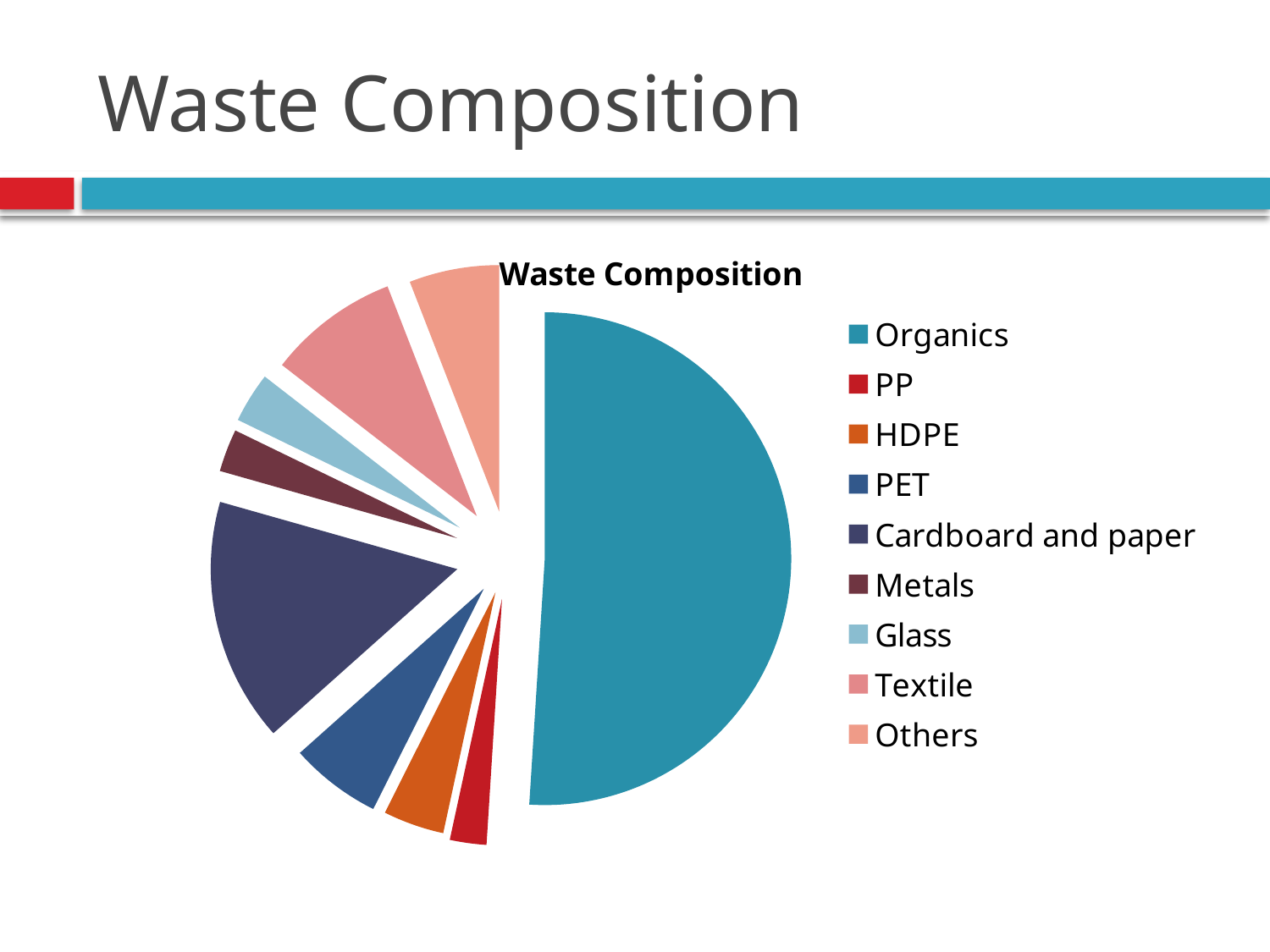
What is the title of the chart? Waste Composition How many categories does the pie chart show? 9 Which category is the second-largest slice of the pie? Cardboard and paper What kind of chart is shown on the slide? Pie chart Which slice is larger, Textile or Glass? Textile Which slice is larger, Cardboard and paper or HDPE? Cardboard and paper Which slice is larger, Cardboard and paper or Textile? Cardboard and paper How many entries does the legend list? 9 Which category is listed last in the legend? Others Which category has the largest slice of the pie? Organics